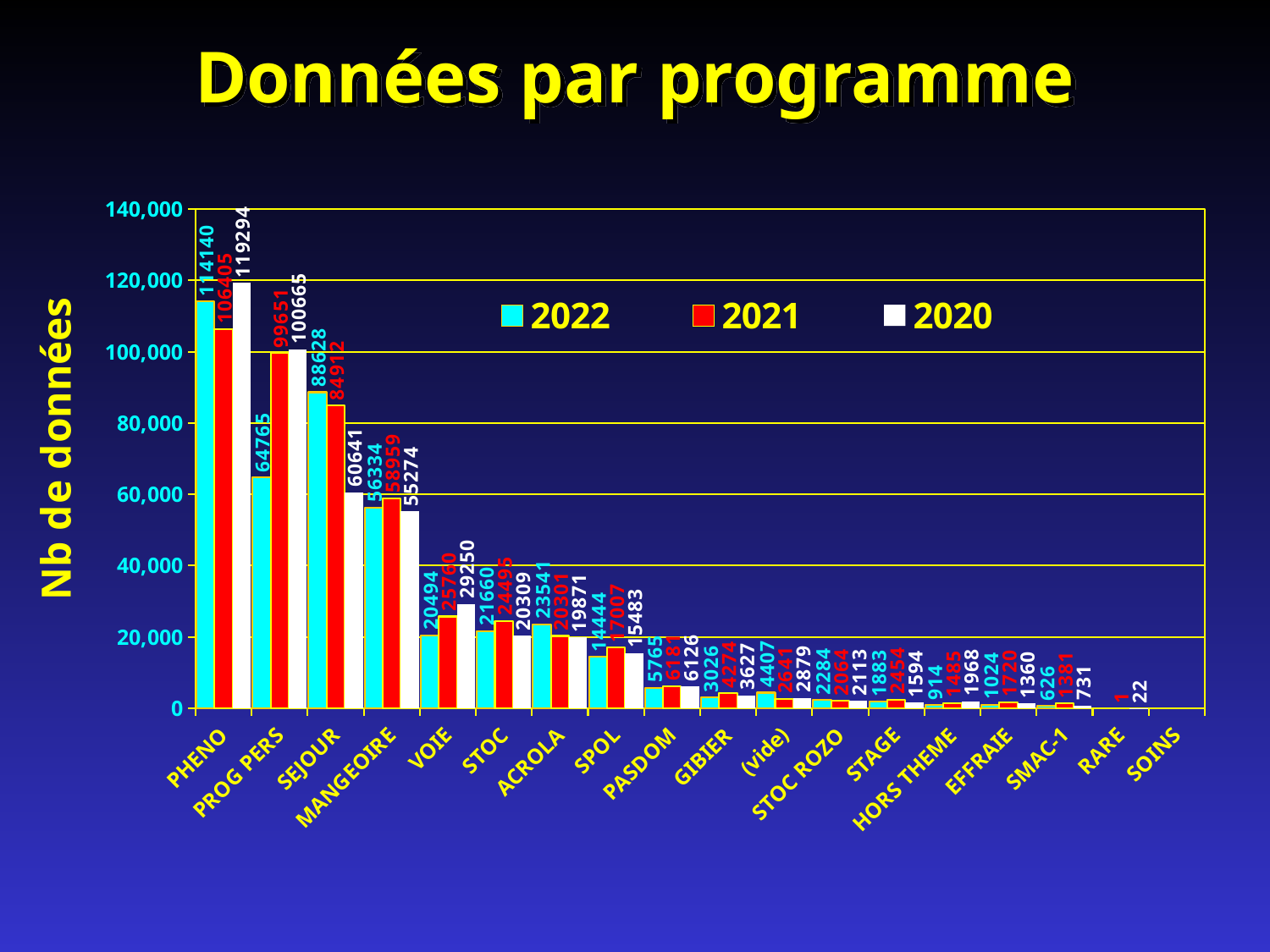
Is the 2021 value for PROG PERS greater or less than 80,000? greater What is the title of the chart? Données par programme What is the difference between the 2020 values for PHENO and PROG PERS? 18629 How many programme categories are shown on the x axis? 18 What is the 2020 value for PHENO? 119294 Which programme has the highest 2020 value? PHENO What is the 2020 value for VOIE? 29250 Which is larger, the 2022 value for SEJOUR or the 2022 value for PROG PERS? SEJOUR What is the 2020 value for PROG PERS? 100665 How many series does the legend list? 3 What type of chart is shown on the slide? bar chart What is the 2022 value for SEJOUR? 88628